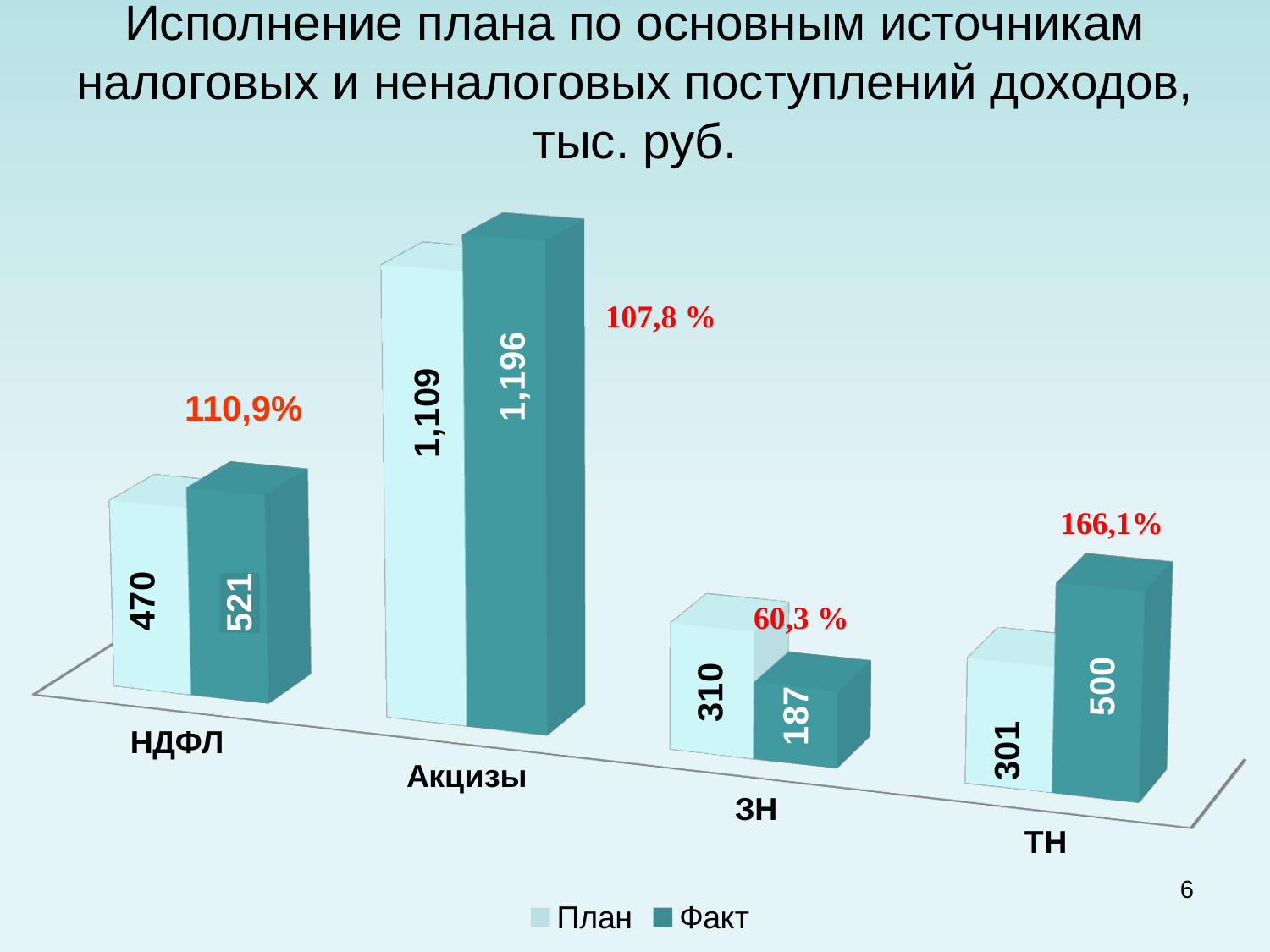
Что больше по категории ЗН: план или факт? План Сколько рядов данных указано в легенде диаграммы? 2 По какой категории значение факта (Факт) наименьшее? ЗН По какой категории значение факта (Факт) наибольшее? Акцизы Какое значение факта (Факт) по категории Акцизы? 1,196 На сколько факт превышает план по категории ТН? 199 Какого типа эта диаграмма? Столбчатая (bar chart) Какой процент исполнения плана указан над столбцами категории ТН? 166,1% Сколько категорий показано на диаграмме? 4 Какое значение плана (План) по категории ТН? 301 Какое значение плана (План) по категории НДФЛ? 470 Какое значение факта (Факт) по категории ЗН? 187